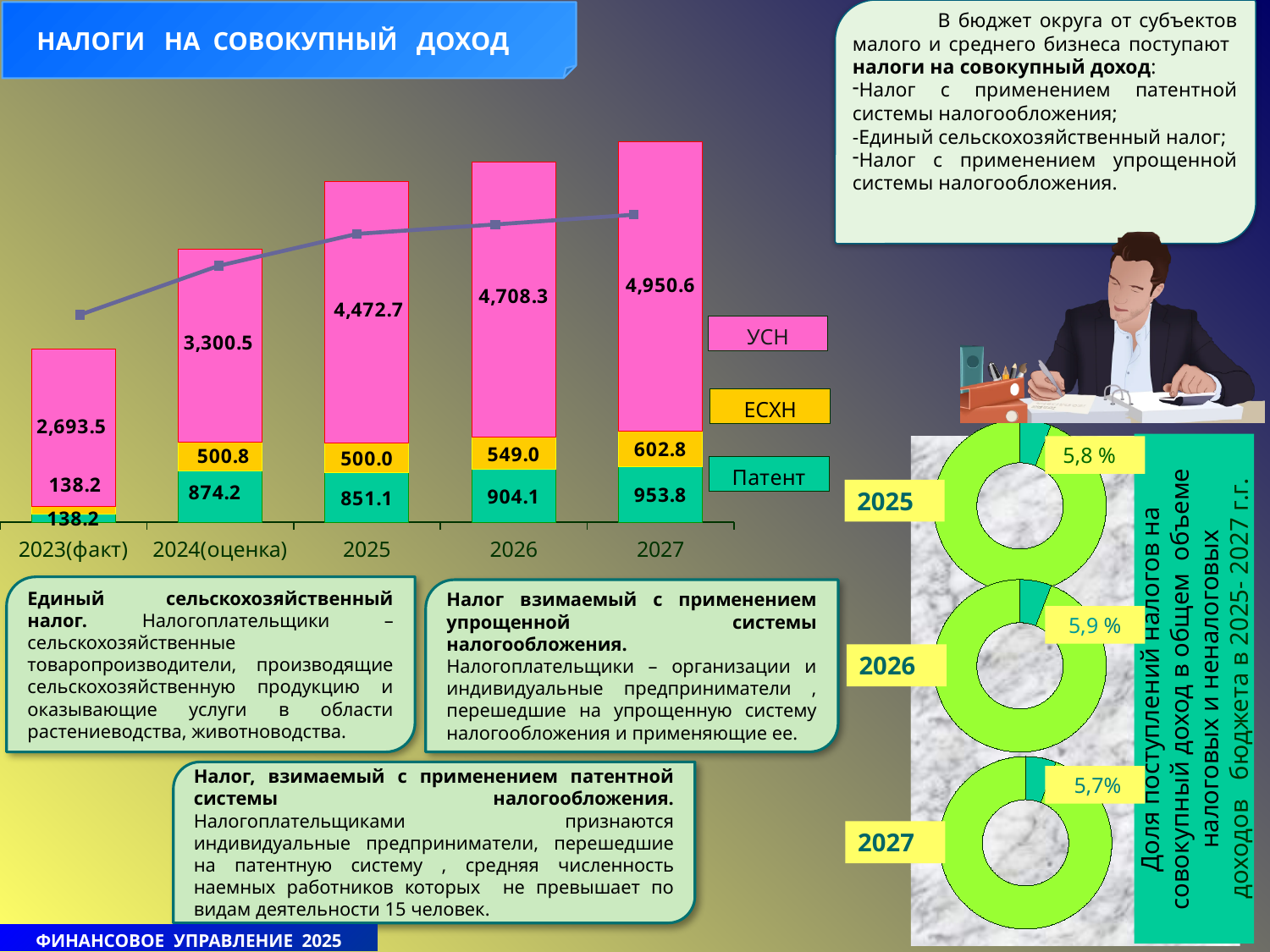
In the stacked bar chart, what is the Патент value for 2024(оценка)? 874.2 In the donut chart for 2026 on the right, what share is shown? 5,9 % In the stacked bar chart, what is the total of the stacked bar for 2027? 6,507.2 How many year categories are shown on the x axis of the stacked bar chart? 5 In the stacked bar chart, which is larger: the Патент value for 2025 or for 2026? 2026 How many series does the legend of the stacked bar chart list? 3 In the stacked bar chart, what is the УСН value for 2027? 4,950.6 In the stacked bar chart, which year has the highest УСН value? 2027 In the stacked bar chart, which year has the lowest Патент value? 2023(факт) In the stacked bar chart, what is the ЕСХН value for 2026? 549.0 In the stacked bar chart, what is the difference between the УСН values for 2027 and 2026? 242.3 Do the УСН values rise or fall from 2023(факт) to 2027 in the stacked bar chart? rise